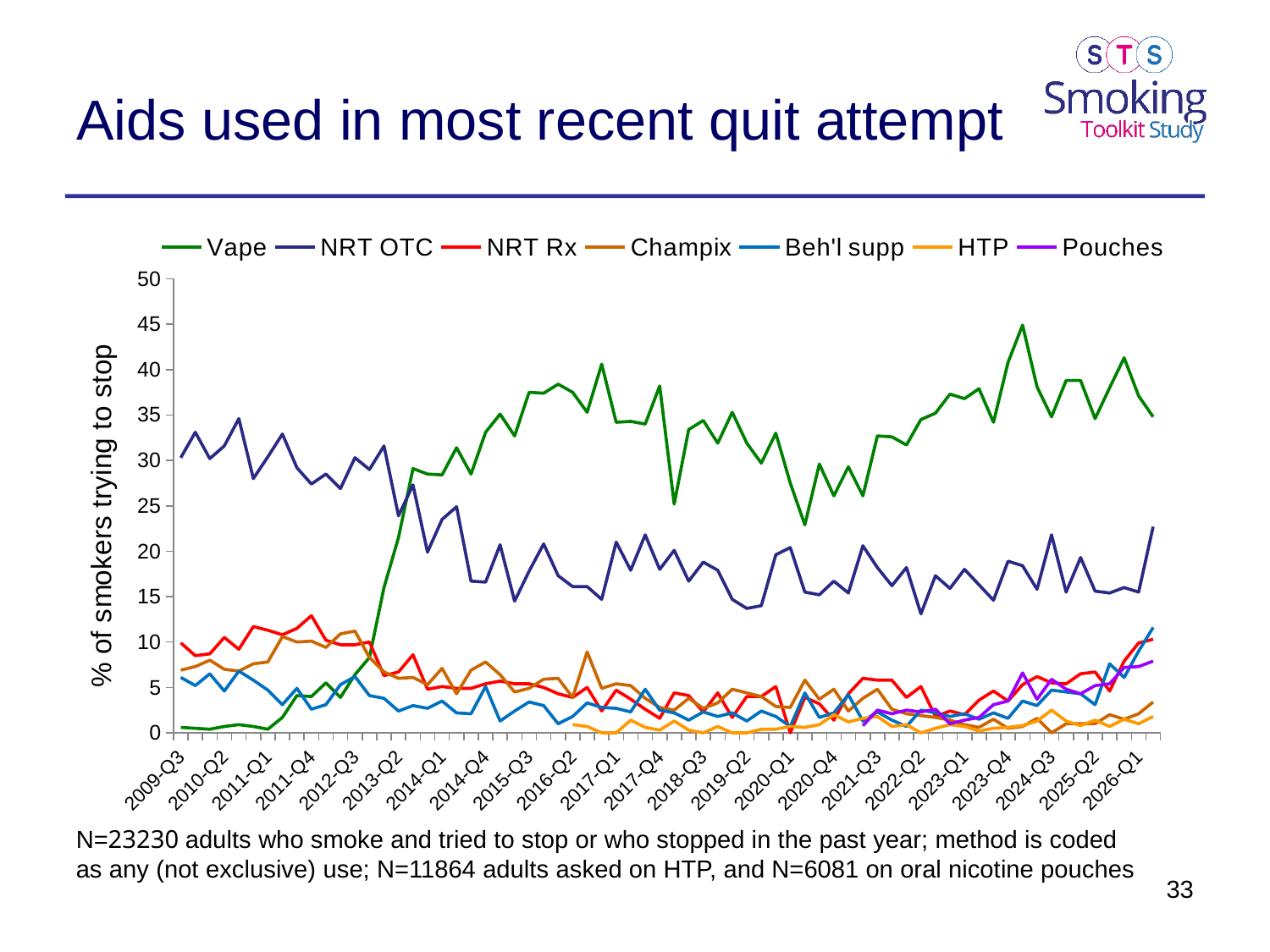
Which series reaches the highest value anywhere on the chart? Vape Is the highest value reached by the Vape line greater or less than 40? greater Is the value for Vape at 2009-Q3 greater or less than 5? less What kind of chart is shown on the slide? line chart Is the value for NRT OTC at 2009-Q3 greater or less than 25? greater What is the label on the vertical axis? % of smokers trying to stop Which series has the lowest value at 2009-Q3? Vape At 2026-Q1, which is higher: Vape or NRT OTC? Vape Does the Vape line generally rise or fall from 2009-Q3 to 2026-Q1? rise How many series does the legend list? 7 What is the title of the chart? Aids used in most recent quit attempt At 2009-Q3, which is higher: NRT OTC or Vape? NRT OTC